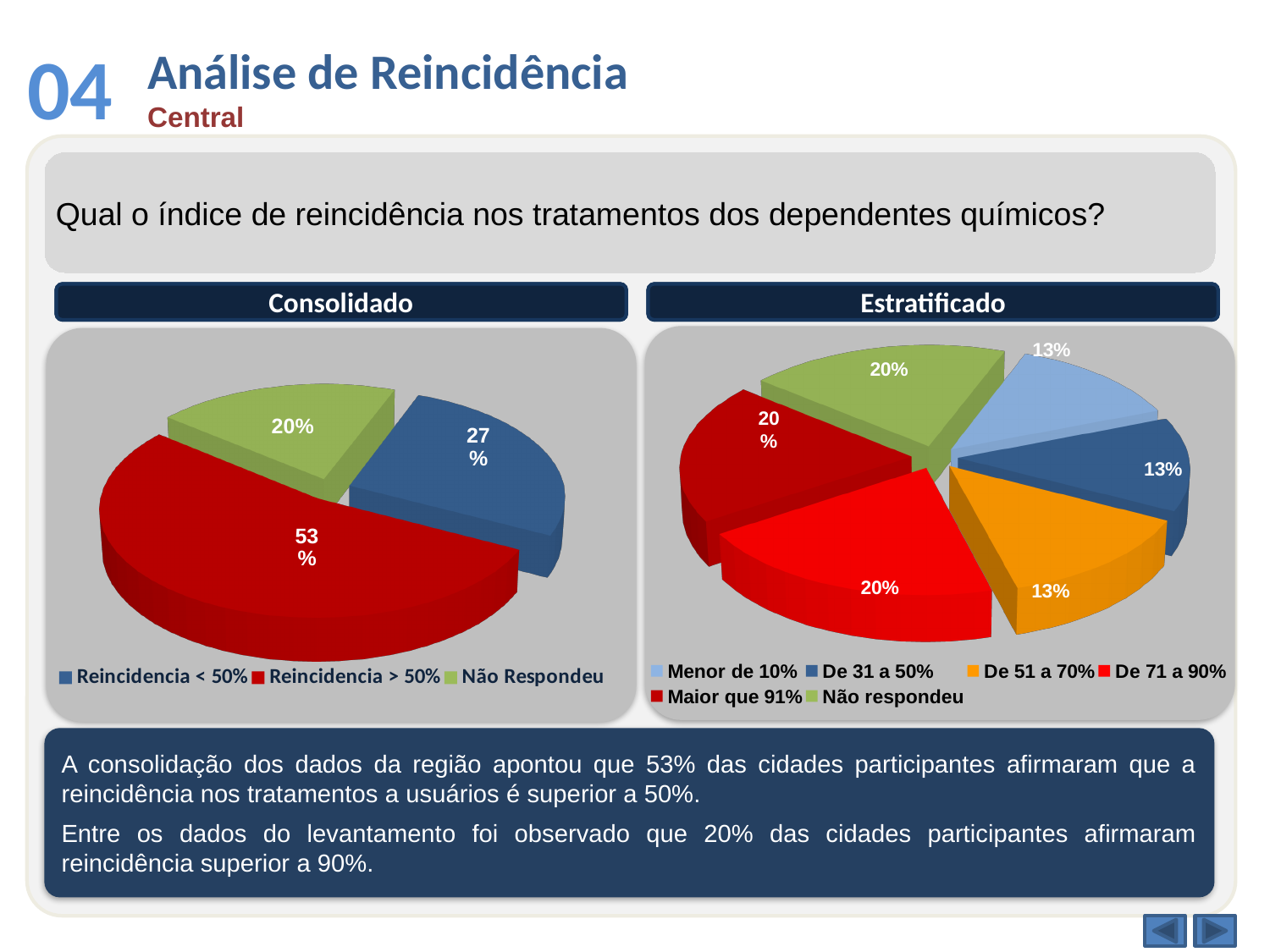
In the Consolidado chart, what is the difference between Reincidencia > 50% and Reincidencia < 50%? 26% In the Consolidado chart, how many slices does the pie have? 3 In the Estratificado chart, what colour is the Não respondeu slice? Green In the Estratificado chart, what percentage is shown for De 51 a 70%? 13% In the Consolidado chart, what percentage is shown for Reincidencia < 50%? 27% What type of chart is the Estratificado chart? Pie chart In the Consolidado chart, which category has the largest slice? Reincidencia > 50% In the Consolidado chart, which category has the smallest slice? Não Respondeu How many categories does the legend of the Estratificado chart list? 6 In the Estratificado chart, which is larger: De 71 a 90% or De 31 a 50%? De 71 a 90% In the Estratificado chart, what percentage is shown for Maior que 91%? 20% In the Consolidado chart, what percentage is shown for Reincidencia > 50%? 53%